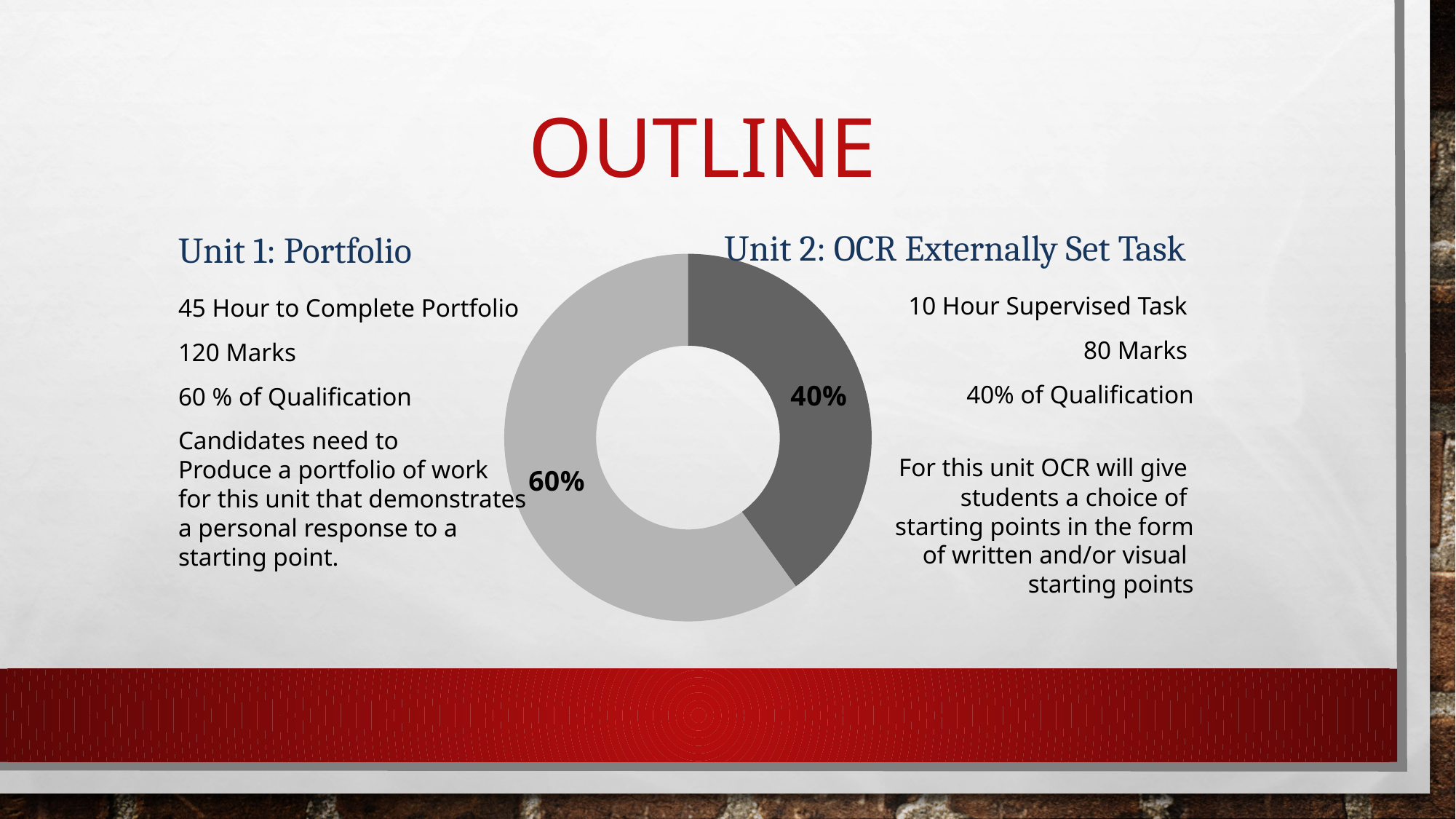
How many slices does the doughnut chart have? 2 Which slice of the doughnut chart is larger, the light grey one or the dark grey one? The light grey one What colour is the slice labelled 40% on the doughnut chart? Dark grey Does the doughnut chart on the slide have a legend? No What do the two slice values on the doughnut chart add up to? 100% What is the data label on the larger, light grey slice of the doughnut chart? 60% What share of the doughnut chart does the dark grey slice represent? 40% What is the smallest value shown on the doughnut chart? 40% What is the largest value shown on the doughnut chart? 60% What is the data label on the smaller, dark grey slice of the doughnut chart? 40% What is the difference between the two slice values on the doughnut chart? 20% What kind of chart is shown on the slide? Doughnut chart